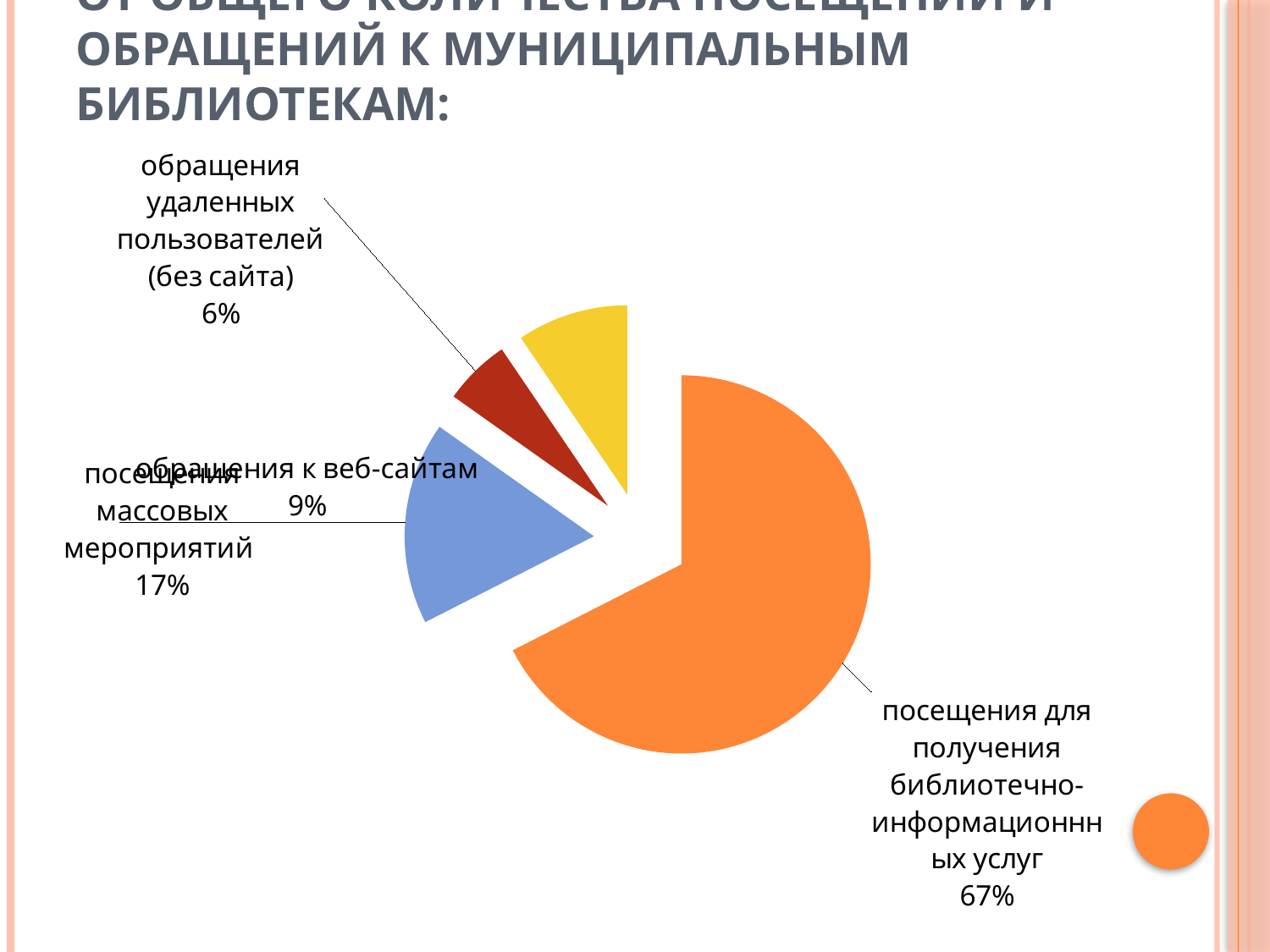
What is the difference in percentage points between "посещения для получения библиотечно-информационнных услуг" and "посещения массовых мероприятий"? 50 What kind of chart is shown on the slide? pie chart Which category has the smallest share of the pie? обращения удаленных пользователей (без сайта) What colour is the largest slice of the pie chart? orange What share of the pie is labelled "посещения массовых мероприятий"? 17% What share of the pie is labelled "посещения для получения библиотечно-информационнных услуг"? 67% How many slices does the pie chart have? 4 Which category has the largest share of the pie? посещения для получения библиотечно-информационнных услуг Which is larger: the share for "обращения к веб-сайтам" or for "обращения удаленных пользователей (без сайта)"? обращения к веб-сайтам What share of the pie is labelled "обращения к веб-сайтам"? 9% What share of the pie is labelled "обращения удаленных пользователей (без сайта)"? 6% What is the difference in percentage points between "посещения массовых мероприятий" and "обращения к веб-сайтам"? 8